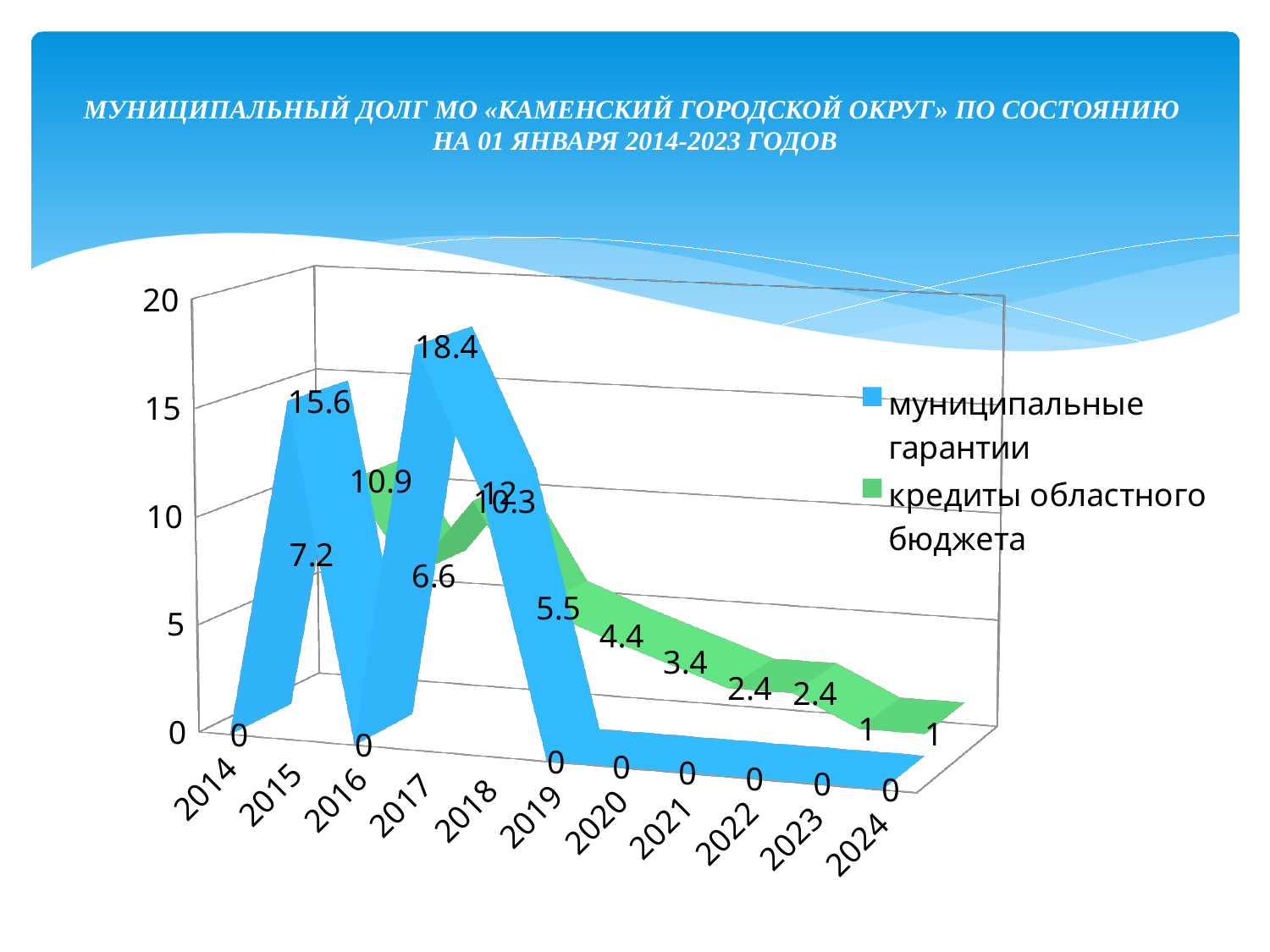
Which series has the larger value in 2015, муниципальные гарантии or кредиты областного бюджета? муниципальные гарантии What is the value of кредиты областного бюджета for 2023? 1 What is the value of муниципальные гарантии for 2017? 18.4 What is the value of муниципальные гарантии for 2015? 15.6 How many series does the legend list? 2 In which year is the value of муниципальные гарантии highest? 2017 What is the value of кредиты областного бюджета for 2019? 4.4 What kind of chart is shown on the slide? line chart What is the difference between the муниципальные гарантии values for 2017 and 2015? 2.8 Do the values of кредиты областного бюджета rise or fall from 2018 to 2024? fall What colour represents кредиты областного бюджета in the legend? green How many years are shown along the x axis? 11